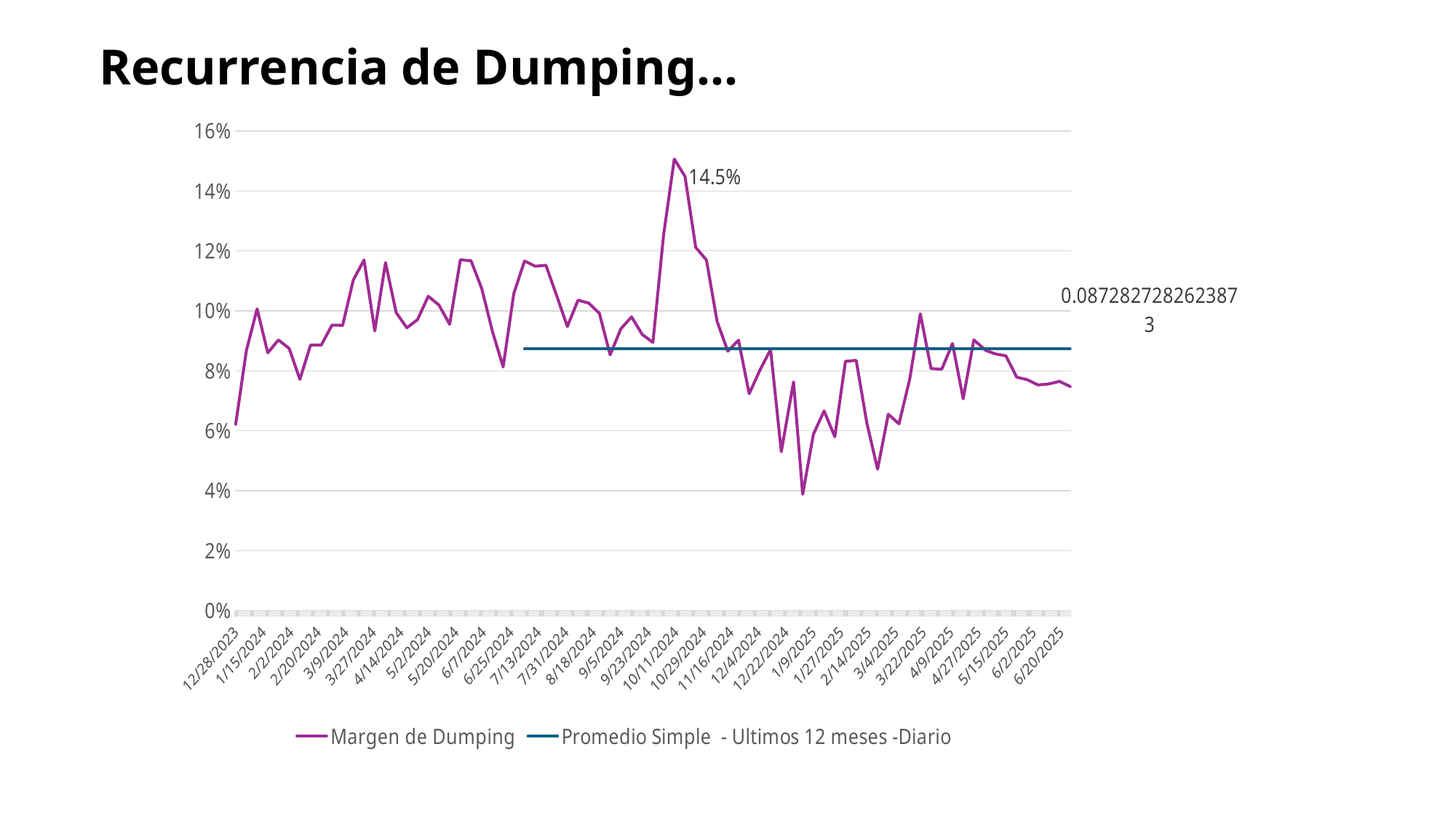
Is the lowest point of the Margen de Dumping line, near 1/9/2025, greater or less than 6%? less What value is printed at the right end of the Promedio Simple - Ultimos 12 meses -Diario line? 0.0872827282623873 At 6/20/2025, is the Margen de Dumping line above or below the Promedio Simple - Ultimos 12 meses -Diario line? below What value is printed as a data label near the peak of the Margen de Dumping line? 14.5% What is the title of the slide containing the chart? Recurrencia de Dumping... Which series is drawn as a flat horizontal line? Promedio Simple - Ultimos 12 meses -Diario Between 10/11/2024 and 1/9/2025, does the Margen de Dumping line generally rise or fall? fall What kind of chart is shown on the slide? line chart How many series does the legend list? 2 Is the value of Margen de Dumping at 12/28/2023 greater or less than 8%? less Is the highest point of the Margen de Dumping line greater or less than 14%? greater